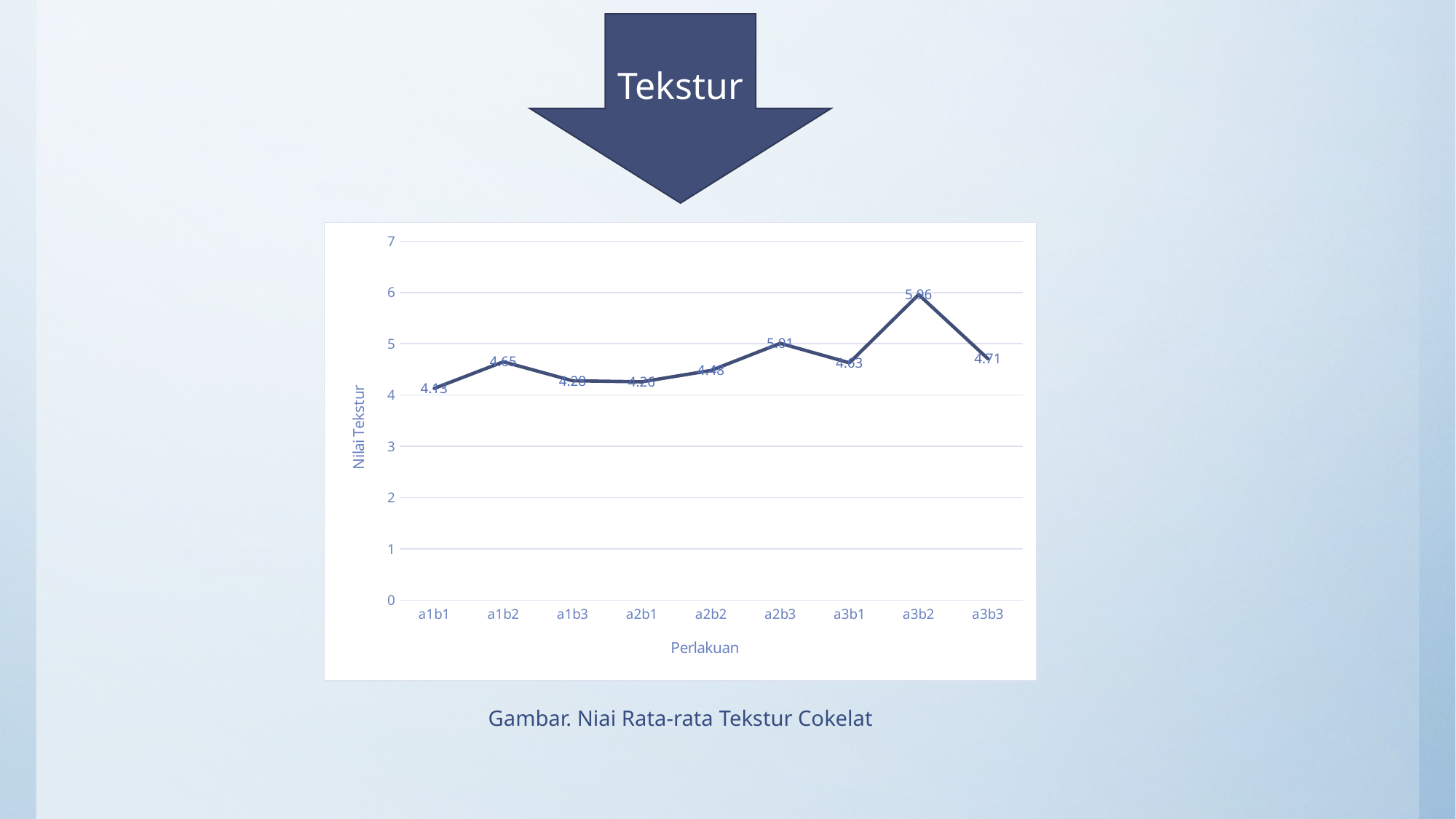
How many treatment categories are plotted along the x axis? 9 Which treatment has the highest texture value? a3b2 Is the value for a2b2 greater or less than 4? greater What kind of chart is shown on the slide? line chart What is the label on the vertical axis of the chart? Nilai Tekstur What is the texture value for a3b3? 4.71 What is the texture value for a1b2? 4.65 Which has a larger texture value, a3b2 or a3b3? a3b2 What is the texture value for a1b1? 4.13 What is the texture value for a3b2? 5.96 What is the difference between the texture values for a3b2 and a1b1? 1.83 Which treatment has the lowest texture value? a1b1